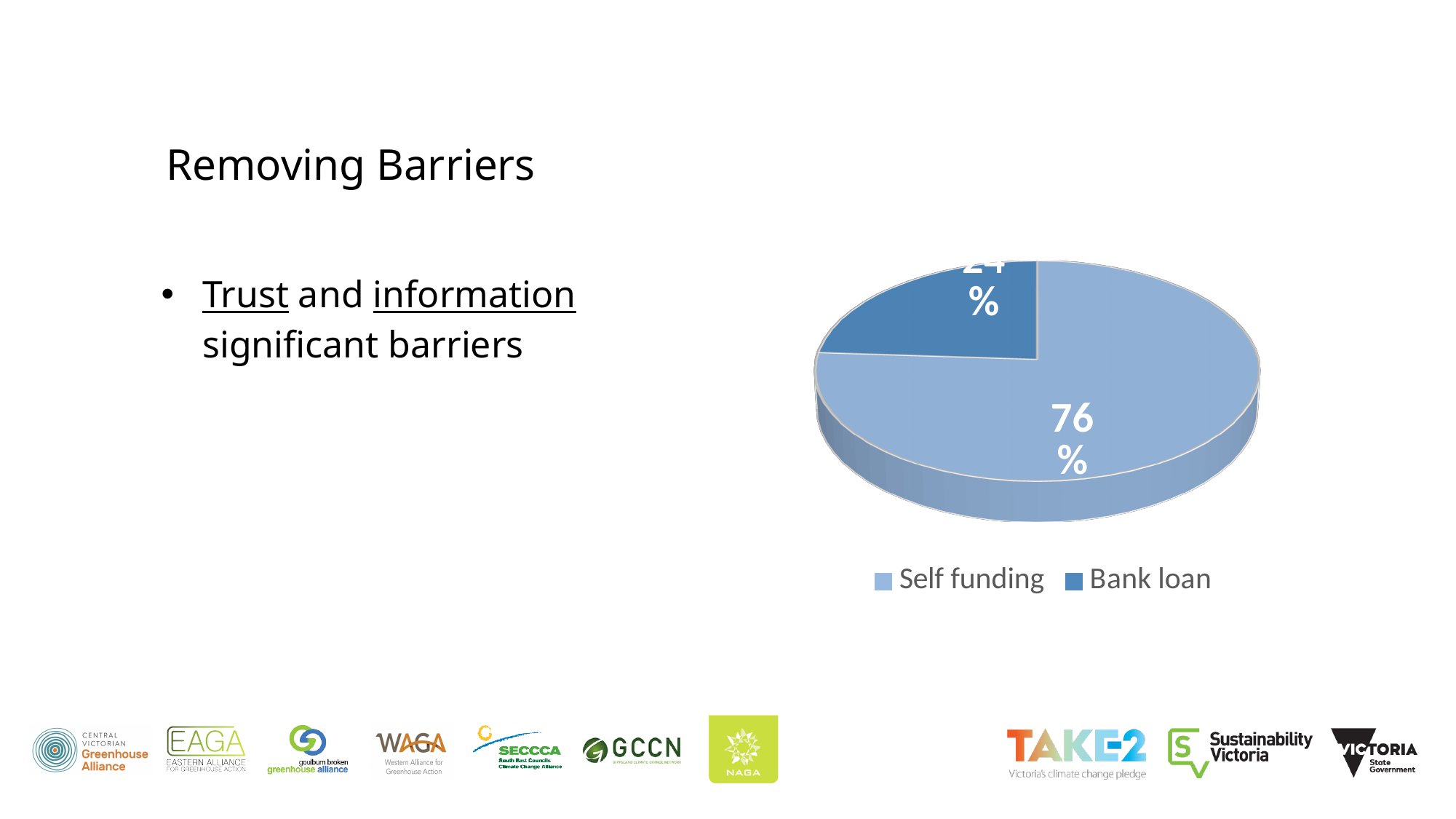
What share of the pie does Bank loan represent? 24% Which legend entry is shown in the darker blue colour? Bank loan What is the difference in percentage points between the Self funding and Bank loan slices? 52 Which slice of the pie is the largest? Self funding How many entries does the legend list? 2 Which is larger, the Self funding slice or the Bank loan slice? Self funding What share of the pie does Self funding represent? 76% What kind of chart is shown on the slide? pie chart What are the two categories listed in the legend? Self funding and Bank loan Which slice of the pie is the smallest? Bank loan How many slices does the pie chart have? 2